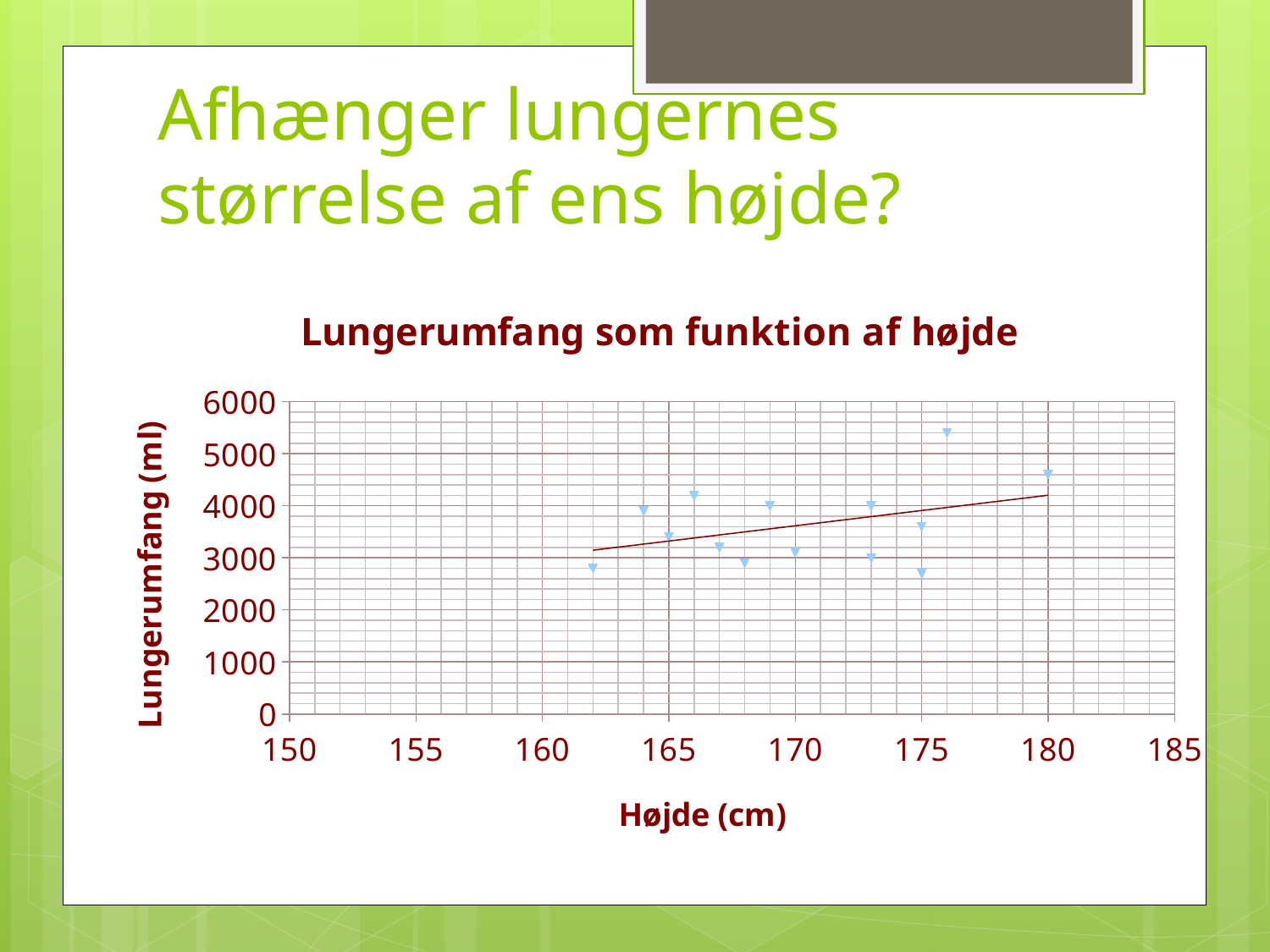
Which plotted point has the larger lung volume: the one at 176 cm or the one at 180 cm? 176 cm What kind of chart is shown on the slide? Scatter chart Is the lung volume plotted at a height of 180 cm greater or less than 4000 ml? greater What is the highest value shown on the vertical axis of the chart? 6000 Is the lung volume plotted at a height of 176 cm greater or less than 5000 ml? greater Does the trend line in the chart rise or fall as height increases? Rises What is the label of the vertical axis of the chart? Lungerumfang (ml) Is the lung volume plotted at a height of 166 cm greater or less than 4000 ml? greater What is the title of the chart? Lungerumfang som funktion af højde